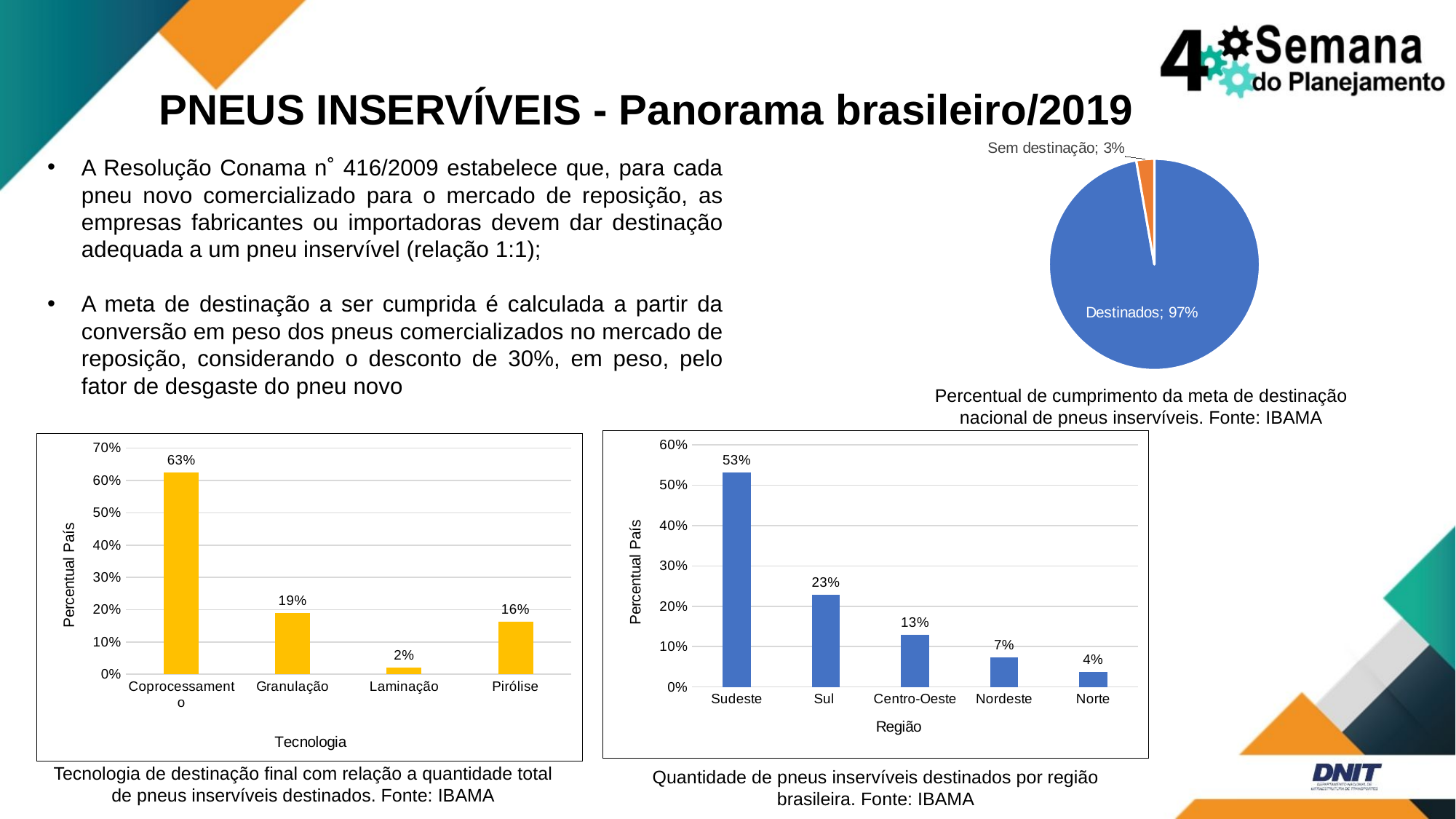
In the 'Região' bar chart at the bottom centre, which is larger, Nordeste or Norte? Nordeste In the 'Região' bar chart at the bottom centre, do the values rise or fall from left to right along the x axis? Fall In the pie chart at the top right, what share is labelled 'Destinados'? 97% In the 'Tecnologia' bar chart at the bottom left, how many technologies are shown? 4 In the pie chart at the top right, what share is labelled 'Sem destinação'? 3% In the 'Região' bar chart at the bottom centre, which region has the highest value? Sudeste In the 'Tecnologia' bar chart at the bottom left, what is the difference between Granulação and Pirólise? 3% In the 'Região' bar chart at the bottom centre, what is the difference between Sudeste and Sul? 30% In the 'Tecnologia' bar chart at the bottom left, what is the value for Coprocessamento? 63% In the 'Região' bar chart at the bottom centre, what is the value for Centro-Oeste? 13% What kind of chart is the chart at the top right of the slide? Pie chart In the 'Tecnologia' bar chart at the bottom left, which technology has the lowest value? Laminação